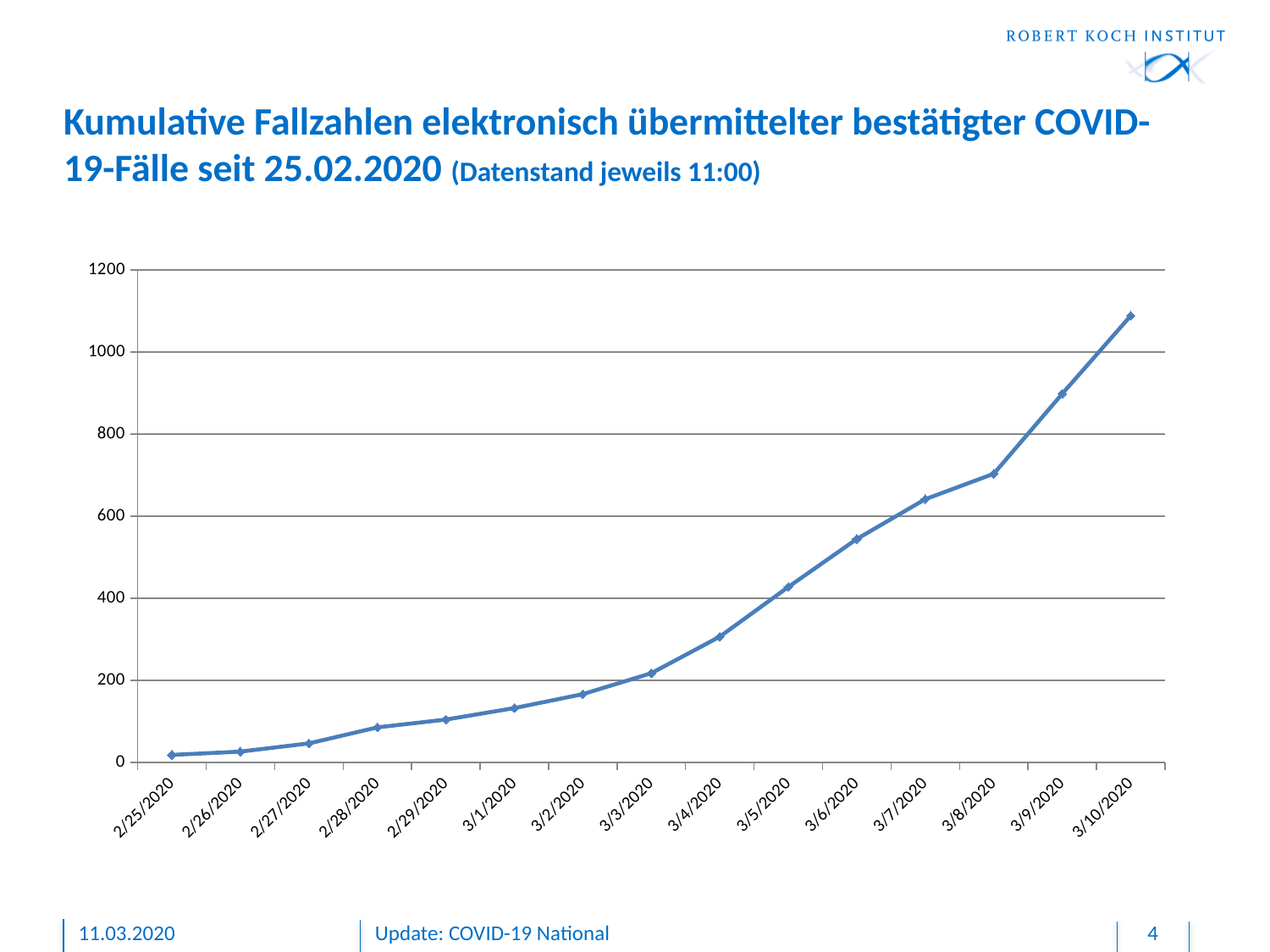
On which date is the plotted value lowest? 2/25/2020 Do the cumulative case numbers rise or fall from 2/25/2020 to 3/10/2020? rise How many dates are plotted on the x axis of the chart? 15 Is the value for 3/5/2020 greater or less than 400? greater On which date is the plotted value highest? 3/10/2020 Is the value for 3/10/2020 greater or less than 1000? greater Is the value for 3/8/2020 greater or less than 800? less What is the highest value shown on the y axis of the chart? 1200 Which date has the larger value, 3/6/2020 or 3/4/2020? 3/6/2020 What kind of chart is shown on the slide? line chart